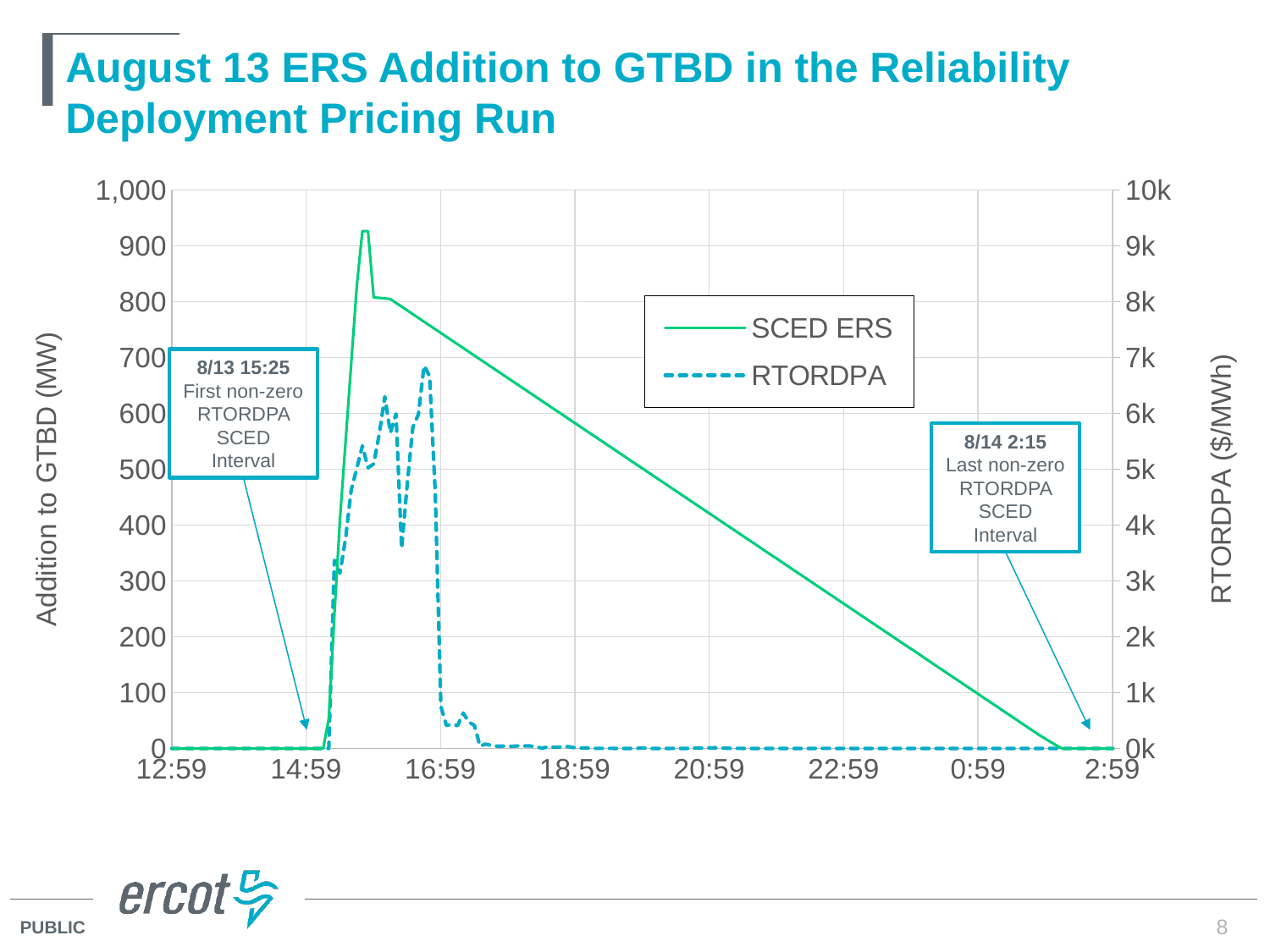
What is the RTORDPA value at 22:59? 0k What kind of chart is shown on the slide? line chart Which series is drawn with a dashed line? RTORDPA Is the peak value of the RTORDPA series greater or less than 5k? greater What is the title of the chart on the slide? August 13 ERS Addition to GTBD in the Reliability Deployment Pricing Run What is the SCED ERS value at 12:59? 0 Is the SCED ERS value at 20:59 greater or less than 500? less Does the SCED ERS series rise or fall between 16:59 and 2:59? fall Does the SCED ERS series rise or fall between 14:59 and 15:59? rise Is the peak value of the SCED ERS series greater or less than 900? greater How many series does the legend list? 2